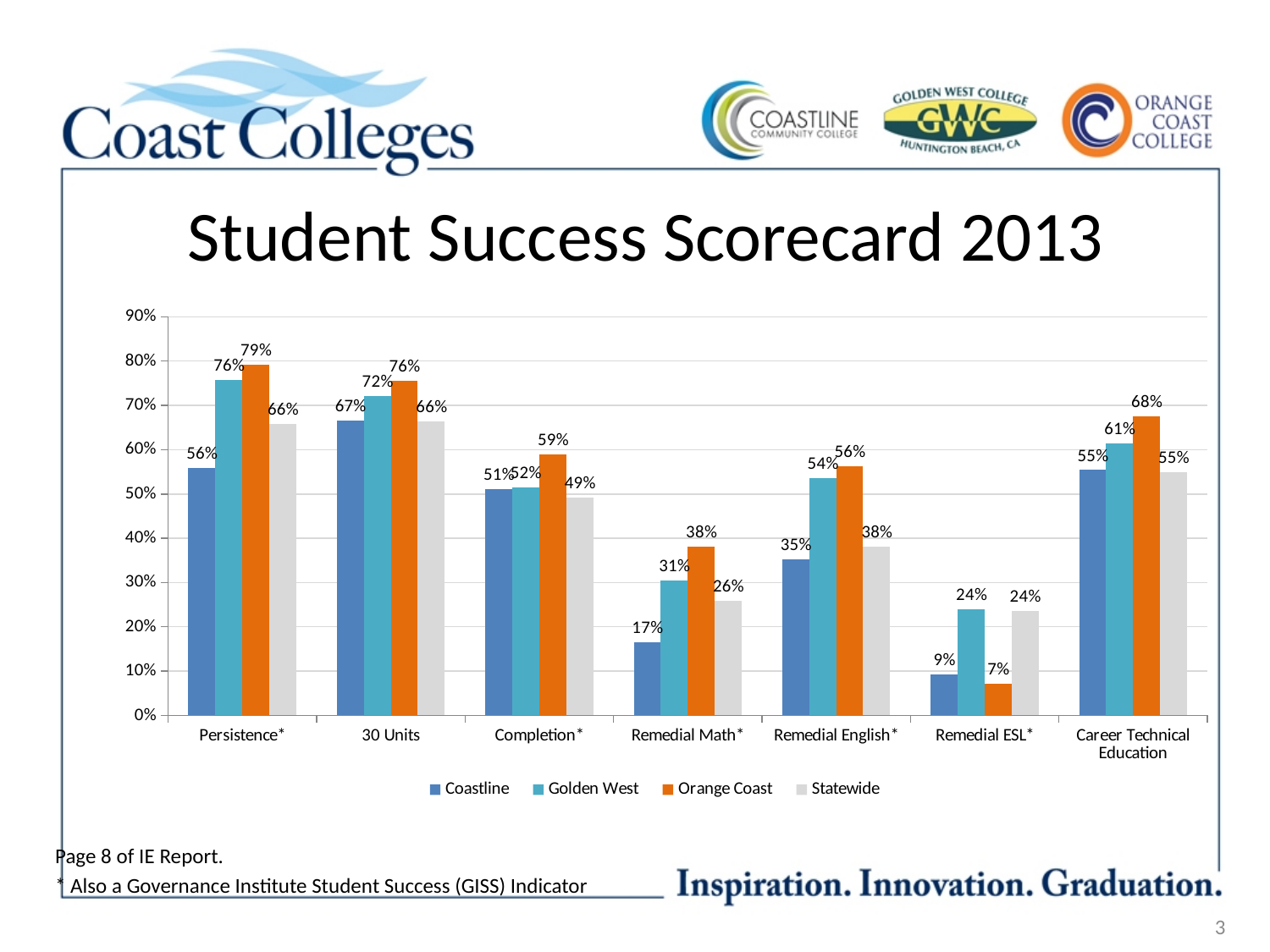
How many series does the legend list? 4 How many categories are shown on the x axis? 7 What is the Orange Coast value for Persistence*? 79% What kind of chart is shown on the slide? Bar chart What is the title of the chart? Student Success Scorecard 2013 What is the difference between the Orange Coast and Coastline values for Remedial English*? 21% Which category has the lowest Orange Coast value? Remedial ESL* What is the Statewide value for Completion*? 49% Which is larger for Remedial ESL*: the Coastline value or the Golden West value? Golden West What is the Golden West value for Career Technical Education? 61% What is the Coastline value for Remedial Math*? 17% Which category has the highest Coastline value? 30 Units